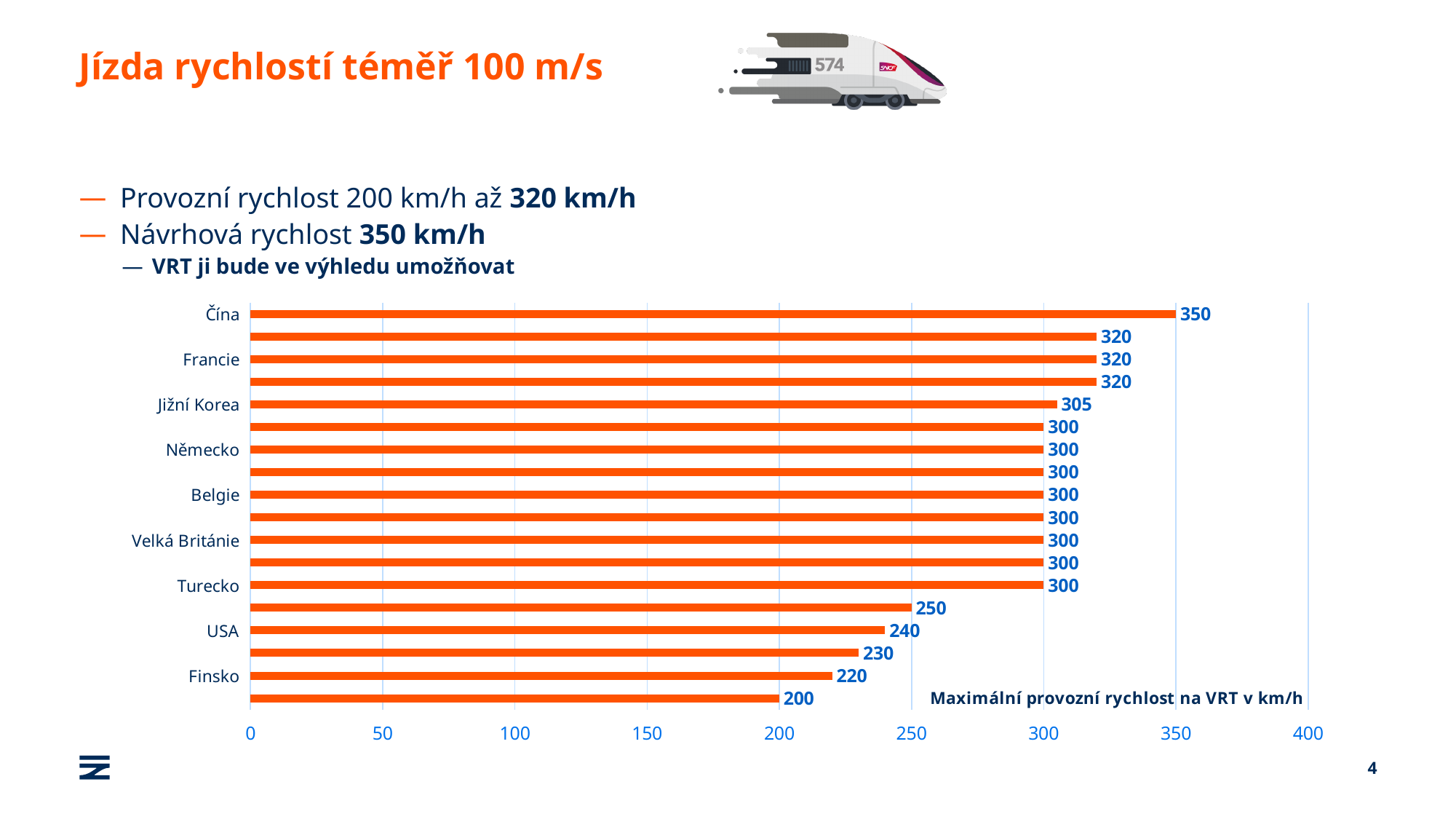
What is the value for Čína? 350 What is the value for Finsko? 220 What is the difference between the values for USA and Finsko? 20 Which is larger, the value for Jižní Korea or the value for Německo? Jižní Korea What kind of chart is shown? bar chart What is the smallest value shown on the chart? 200 What is the difference between the values for Čína and Francie? 30 What is the value for USA? 240 What is the axis title shown on the chart? Maximální provozní rychlost na VRT v km/h Which category has the highest value? Čína What is the value for Jižní Korea? 305 Is the value for USA greater or less than 250? less